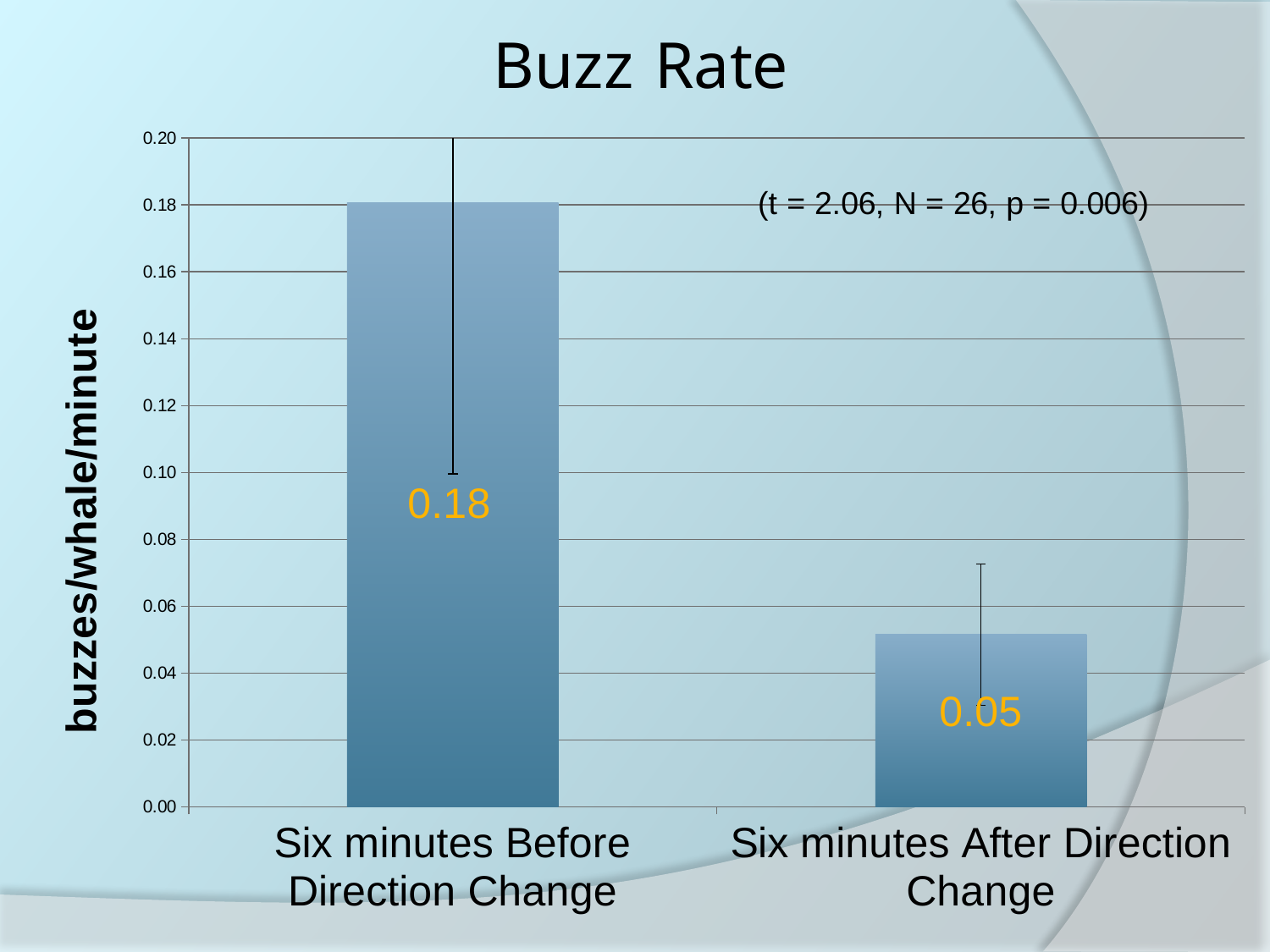
How many categories are shown on the chart? 2 What is the label of the vertical axis? buzzes/whale/minute What is the buzz rate for Six minutes Before Direction Change? 0.18 What is the difference in buzz rate between Six minutes Before Direction Change and Six minutes After Direction Change? 0.13 What is the buzz rate for Six minutes After Direction Change? 0.05 Which category has the highest buzz rate? Six minutes Before Direction Change What kind of chart is shown on the slide? Bar chart Is the value for Six minutes After Direction Change greater or less than 0.10? less What is the title of the chart? Buzz Rate Is the value for Six minutes Before Direction Change greater or less than 0.14? greater Which is larger: the buzz rate Six minutes Before Direction Change or Six minutes After Direction Change? Six minutes Before Direction Change Which category has the lowest buzz rate? Six minutes After Direction Change